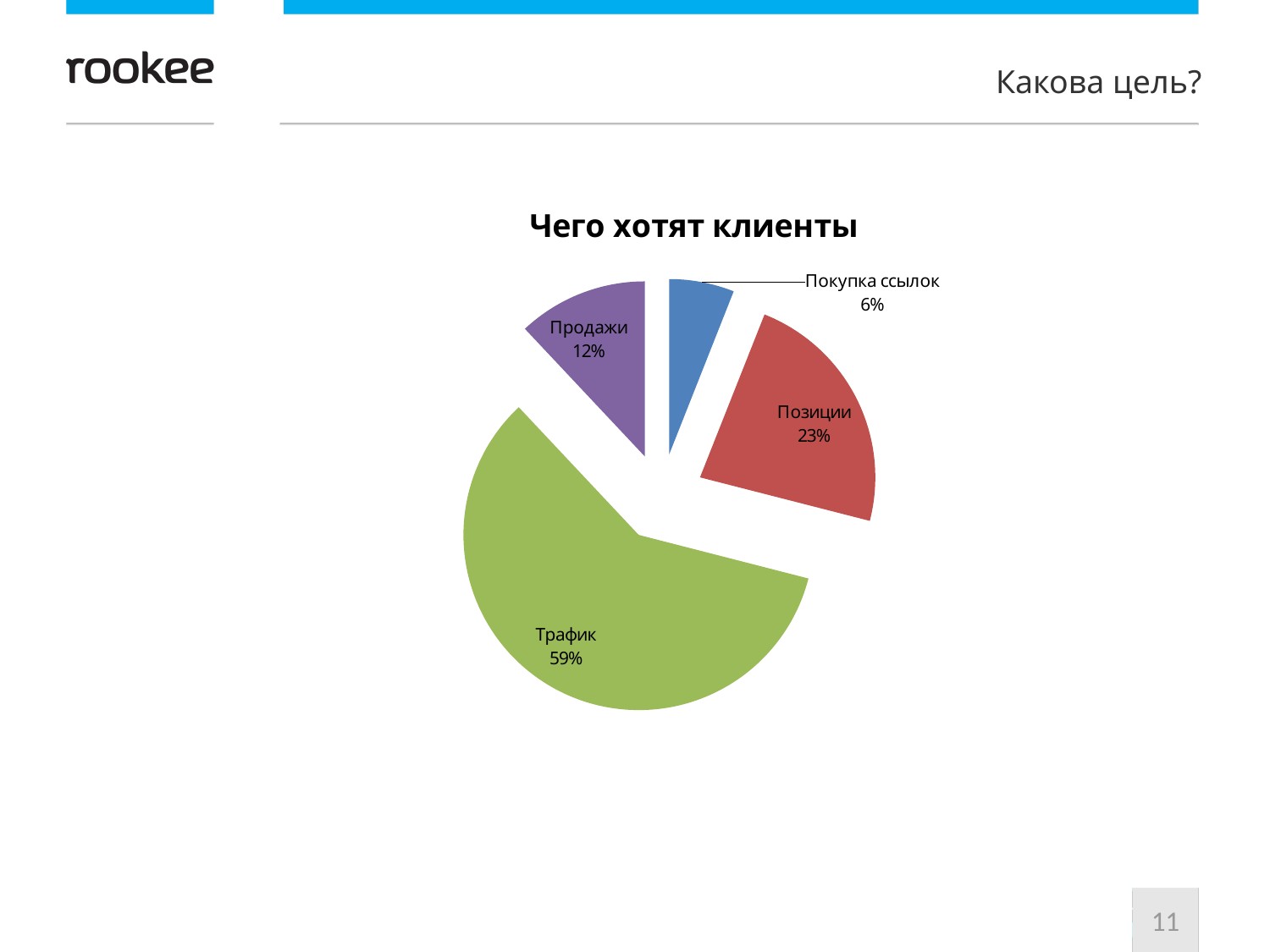
What is the title of the chart? Чего хотят клиенты What colour is the Трафик slice? green Which is larger, the share for Продажи or the share for Покупка ссылок? Продажи What type of chart is shown on the slide? pie chart What is the difference in percentage points between Трафик and Позиции? 36 What share of the pie does Позиции have? 23% What share of the pie does Покупка ссылок have? 6% How many categories are shown in the pie chart? 4 What share of the pie does Трафик have? 59% Which category has the largest slice of the pie? Трафик Which category has the smallest slice of the pie? Покупка ссылок